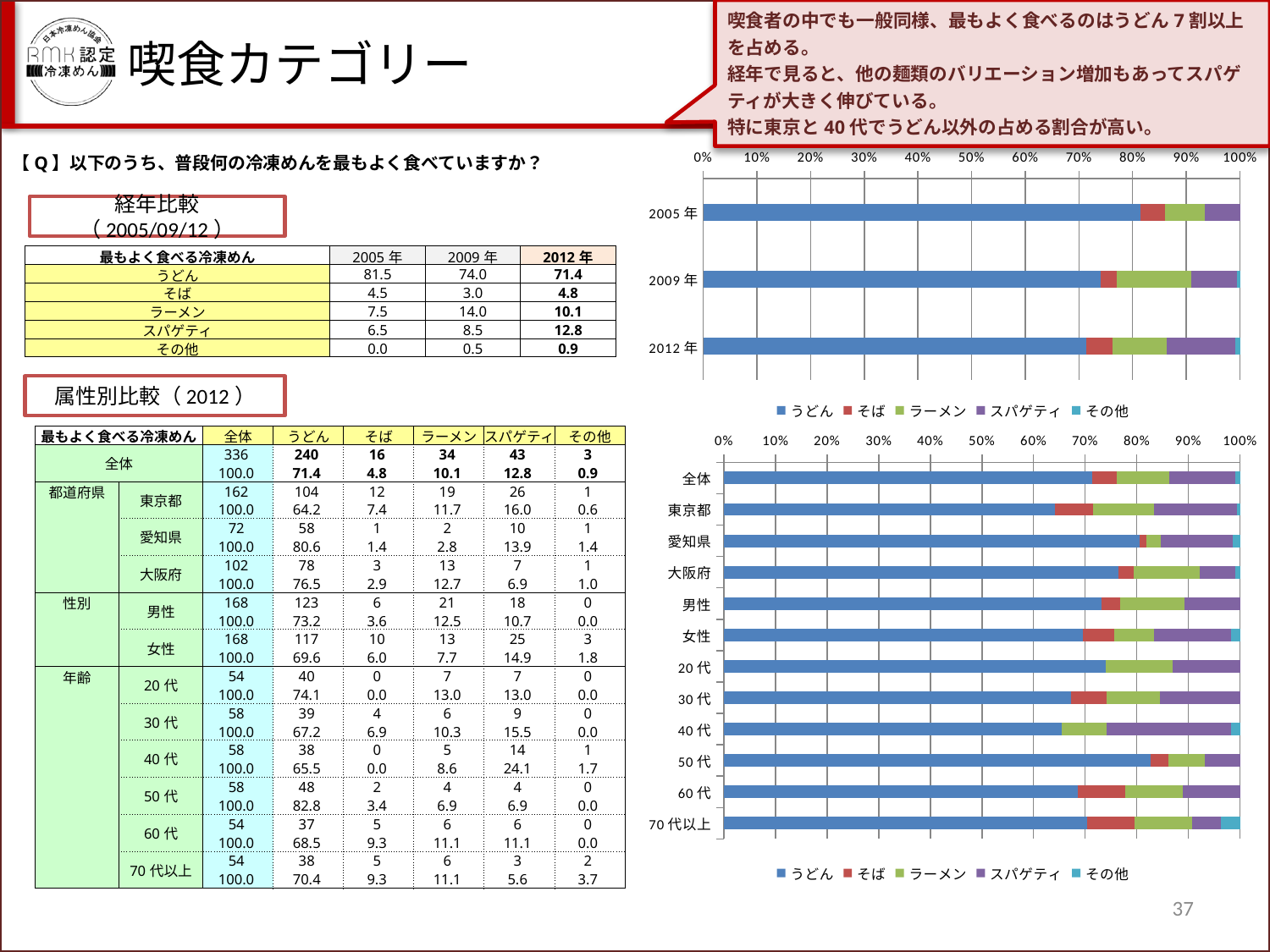
In the bottom chart, which series is shown in blue? うどん How many categories are plotted on the bottom chart (全体 to 70代以上)? 12 In the top chart, what is the value of スパゲティ for 2012年? 12.8 In the top chart, what is the value of うどん for 2005年? 81.5 What kind of chart is the top chart (2005年/2009年/2012年)? bar chart In the top chart, what is the difference between the うどん value for 2005年 and for 2012年? 10.1 In the bottom chart, which has the larger うどん segment, 40代 or 50代? 50代 In the bottom chart, is the うどん value for 東京都 greater or less than 70%? less In the top chart, does the うどん segment rise or fall from 2005年 to 2012年? fall In the bottom chart, is the うどん value for 愛知県 greater or less than 70%? greater How many series does the legend of the top chart list? 5 In the top chart, is the うどん value for 2009年 greater or less than 70%? greater